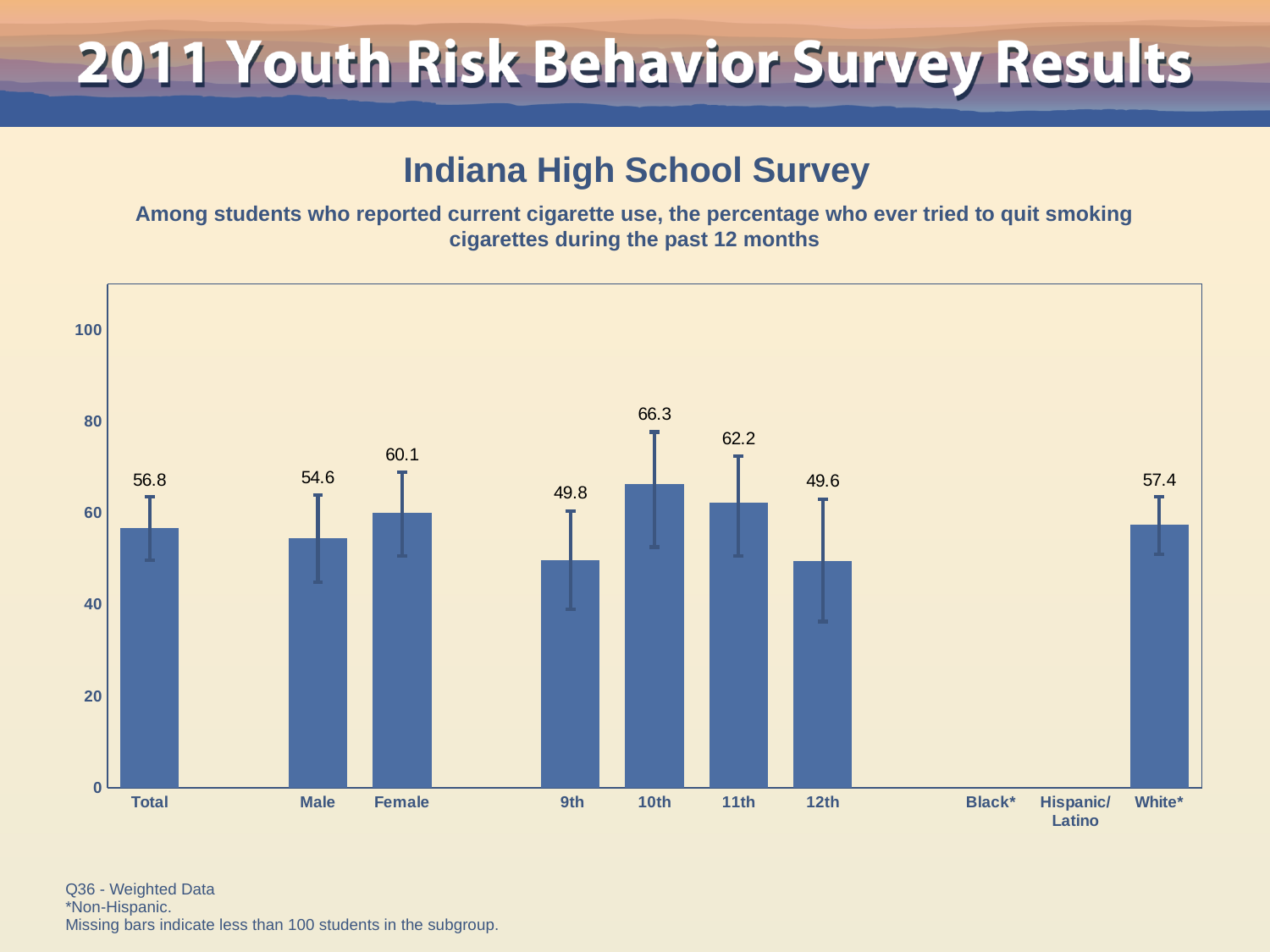
What is the value for Female? 60.1 Which category has the lowest plotted value? 12th Is the value for 9th greater or less than 60? less What is the difference between the values for Female and Male? 5.5 What is the value for 12th? 49.6 What is the value for White*? 57.4 What kind of chart is shown? bar chart What is the value for Total? 56.8 Which categories have no bar shown? Black* and Hispanic/Latino Which category has the highest value? 10th How many categories have a plotted bar? 8 Which is larger, the value for 10th or the value for 11th? 10th